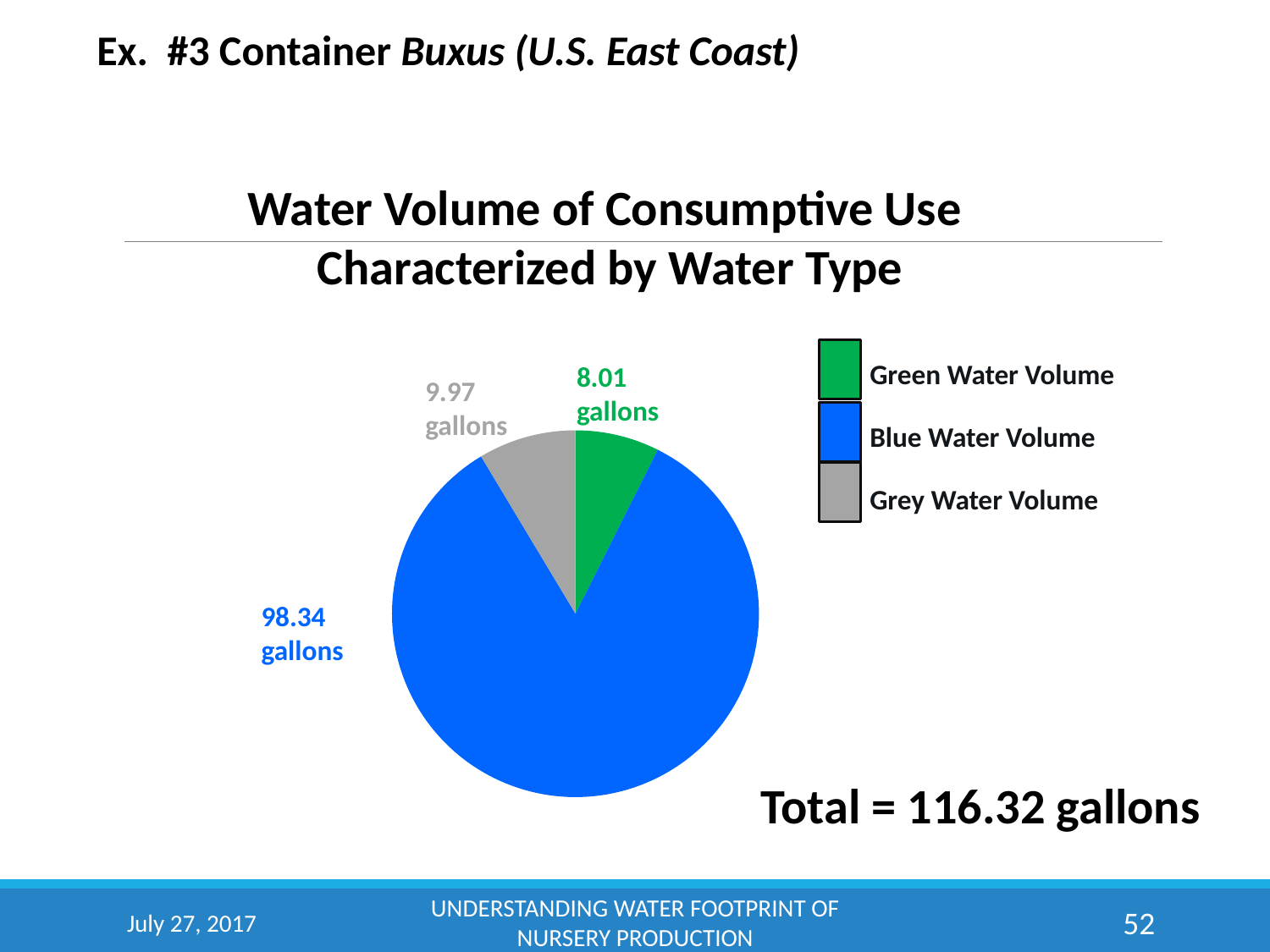
Which water type has the smallest volume in the pie chart? Green Water Volume What is the difference between the Grey Water Volume and the Green Water Volume? 1.96 gallons Which is larger, the Grey Water Volume or the Green Water Volume? Grey Water Volume What is the total water volume stated on the slide? 116.32 gallons What is the Blue Water Volume shown in the pie chart? 98.34 gallons How many slices does the pie chart have? 3 What is the Green Water Volume shown in the pie chart? 8.01 gallons Which water type has the largest volume in the pie chart? Blue Water Volume What type of chart is shown on the slide? Pie chart What is the difference between the Blue Water Volume and the Grey Water Volume? 88.37 gallons What is the Grey Water Volume shown in the pie chart? 9.97 gallons What is the title of the pie chart? Water Volume of Consumptive Use Characterized by Water Type